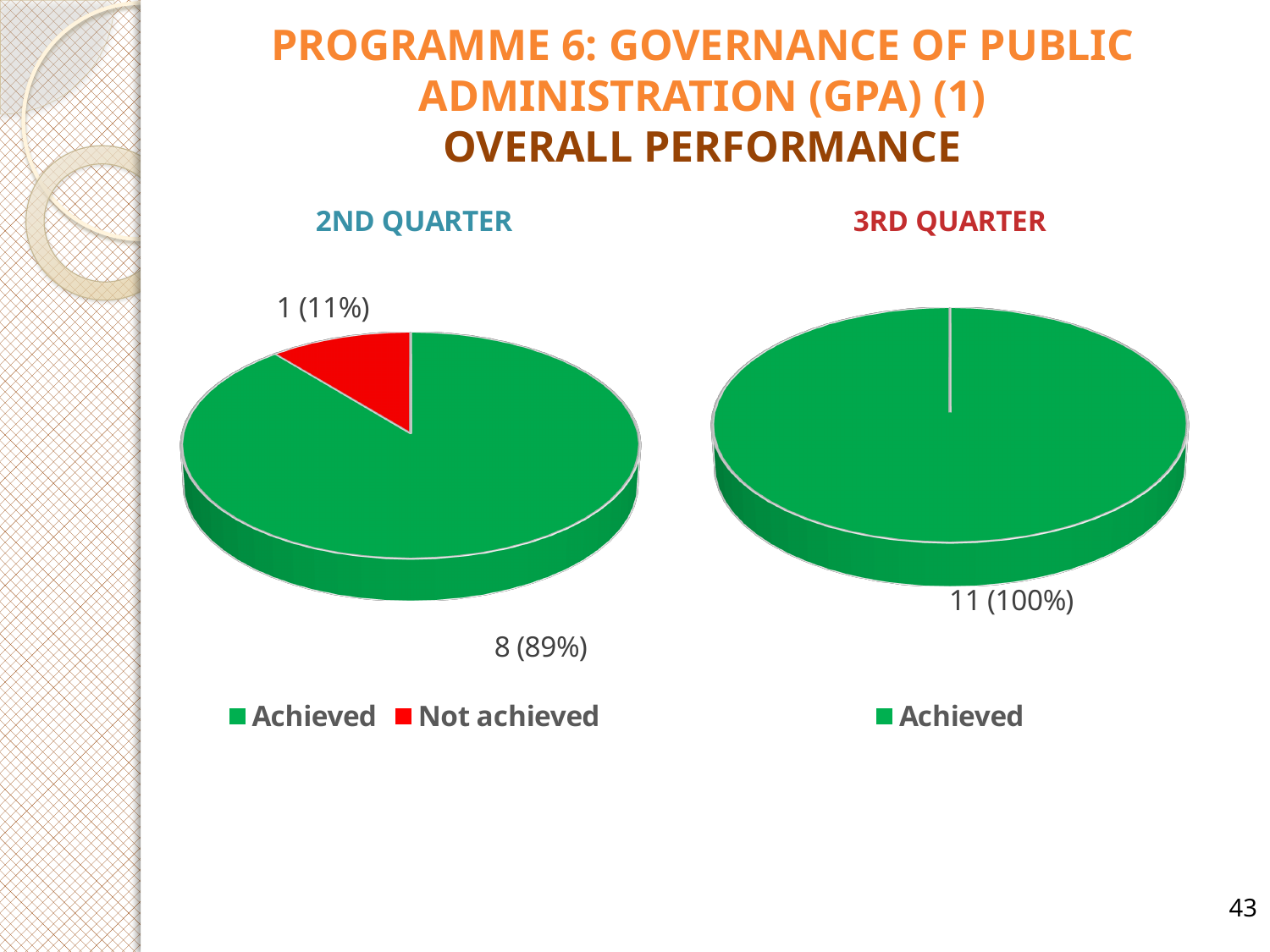
In the 2ND QUARTER chart, what share of the pie is Achieved? 89% How many categories does the legend of the 3RD QUARTER chart list? 1 What kind of chart is the 3RD QUARTER chart? Pie chart In the 2ND QUARTER chart, what is the value for Achieved? 8 (89%) How many categories does the legend of the 2ND QUARTER chart list? 2 In the 2ND QUARTER chart, what colour is the Not achieved slice? Red In the 2ND QUARTER chart, which category has the largest slice? Achieved In the 2ND QUARTER chart, which category has the smallest slice? Not achieved In the 2ND QUARTER chart, what is the difference between the Achieved count and the Not achieved count? 7 In the 2ND QUARTER chart, what share of the pie is Not achieved? 11% In the 3RD QUARTER chart, what is the value for Achieved? 11 (100%) In the 2ND QUARTER chart, what is the value for Not achieved? 1 (11%)